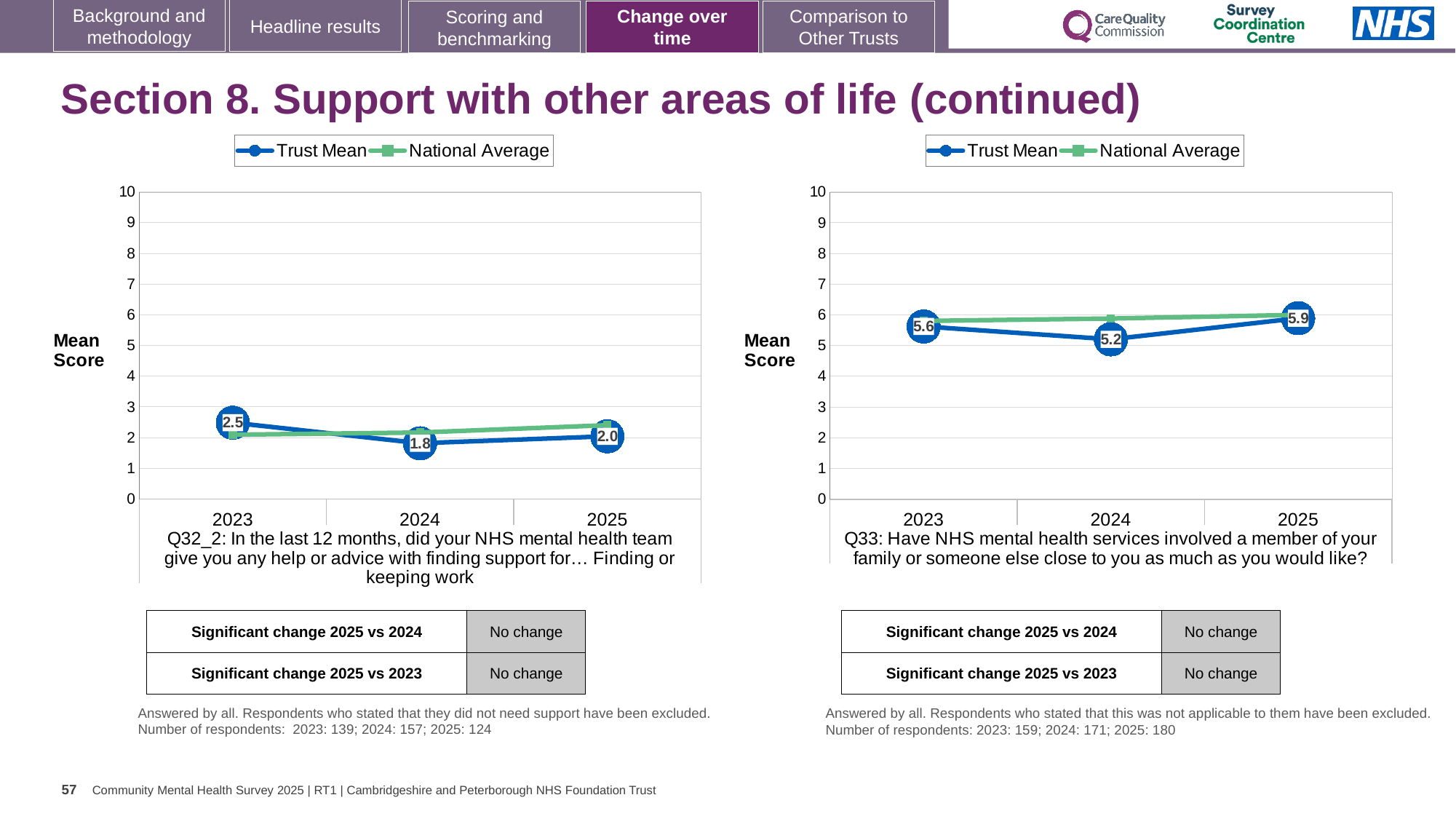
How many series does the legend of the right chart (Q33) list? 2 What type of chart is the left chart (Q32_2)? Line chart In the right chart (Q33), is the Trust Mean for 2023 larger or smaller than the Trust Mean for 2024? larger In the left chart (Q32_2), what is the difference between the Trust Mean for 2023 and 2024? 0.7 In the left chart (Q32_2), is the National Average for 2025 greater or less than 3? less In the right chart (Q33), what is the difference between the Trust Mean for 2025 and 2024? 0.7 In the right chart (Q33), what is the Trust Mean for 2025? 5.9 In the right chart (Q33), which year has the highest Trust Mean? 2025 In the left chart (Q32_2), what is the Trust Mean for 2023? 2.5 In the left chart (Q32_2), which year has the lowest Trust Mean? 2024 In the right chart (Q33), what is the Trust Mean for 2024? 5.2 In the left chart (Q32_2), what is the Trust Mean for 2024? 1.8